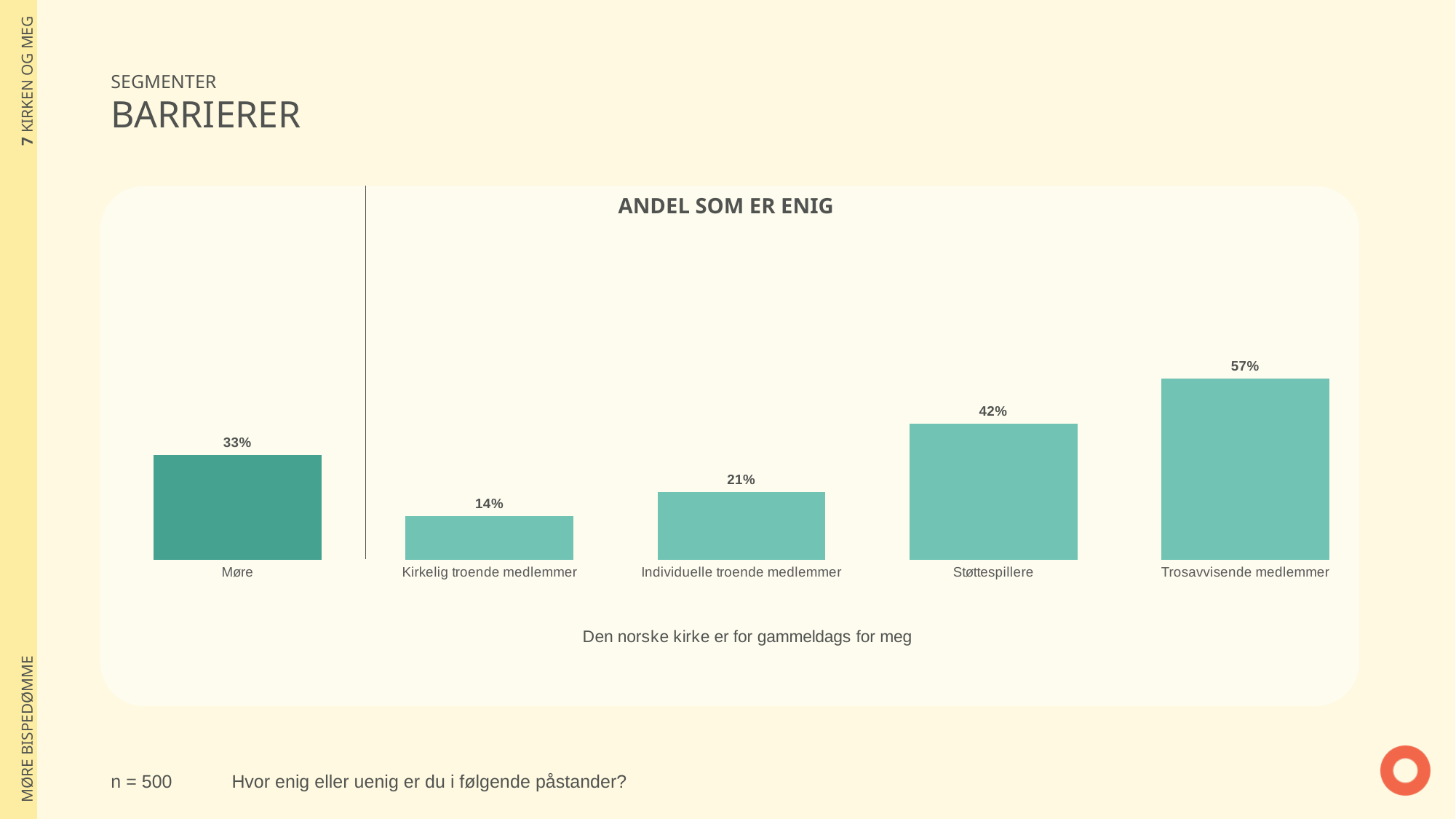
Which is larger, the value for Møre or the value for Individuelle troende medlemmer? Møre What is the value for Kirkelig troende medlemmer? 14% What is the value for Møre? 33% What is the difference between the values for Trosavvisende medlemmer and Støttespillere? 15% How many categories are shown in the chart? 5 Which category has the highest value? Trosavvisende medlemmer Which category has the lowest value? Kirkelig troende medlemmer What is the value for Individuelle troende medlemmer? 21% What is the value for Trosavvisende medlemmer? 57% What kind of chart is shown on the slide? Bar chart What is the value for Støttespillere? 42%